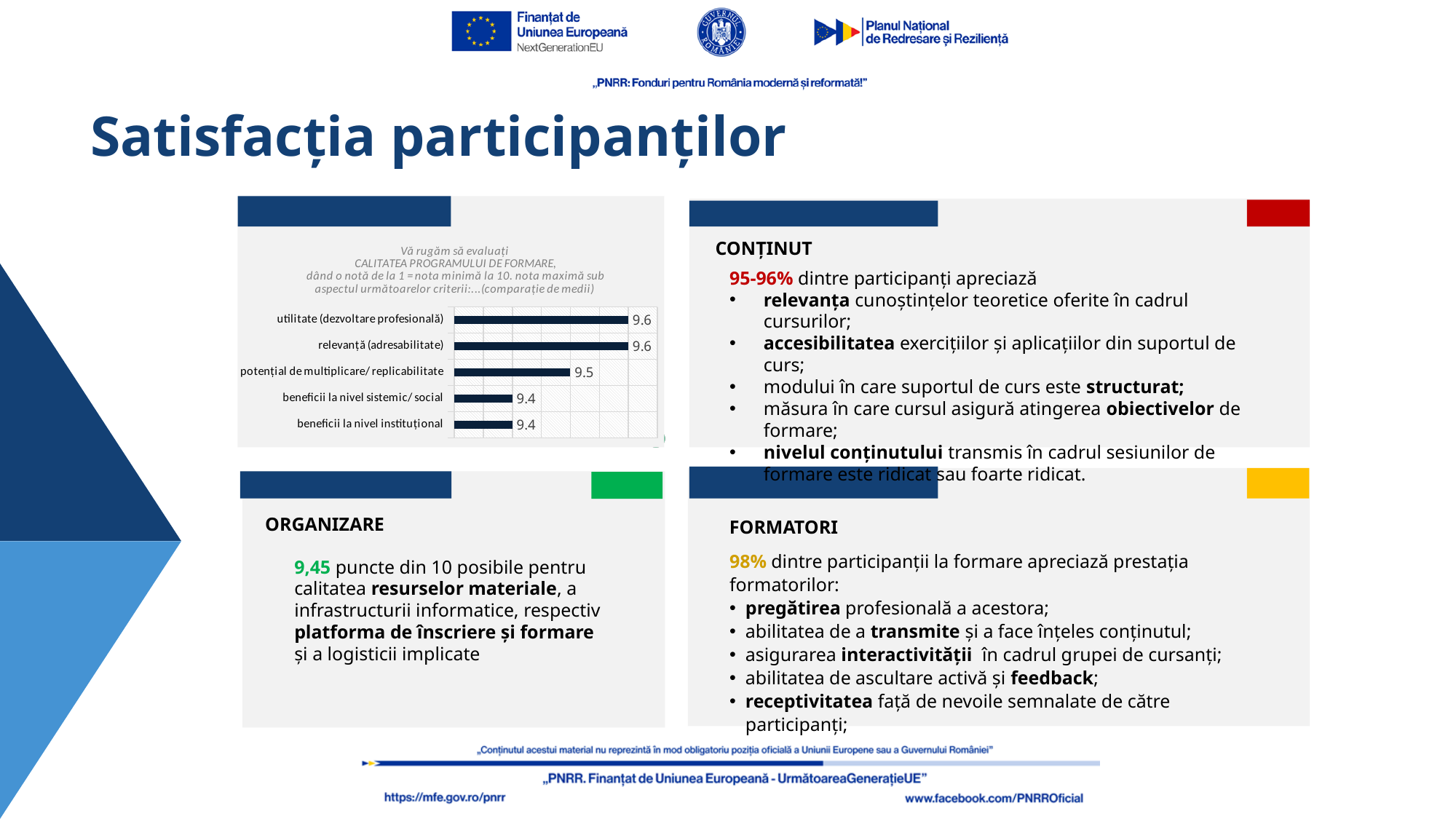
What is the value for 'beneficii la nivel sistemic/ social'? 9.4 What is the value for 'potențial de multiplicare/ replicabilitate'? 9.5 What is the difference between the value for 'utilitate (dezvoltare profesională)' and the value for 'beneficii la nivel instituțional'? 0.2 What kind of chart is shown on the slide? bar chart What is the value for 'relevanță (adresabilitate)'? 9.6 What is the value for 'beneficii la nivel instituțional'? 9.4 What is the highest value shown in the bar chart? 9.6 What is the difference between the value for 'relevanță (adresabilitate)' and the value for 'potențial de multiplicare/ replicabilitate'? 0.1 What is the lowest value shown in the bar chart? 9.4 Which is larger: the value for 'potențial de multiplicare/ replicabilitate' or the value for 'beneficii la nivel sistemic/ social'? potențial de multiplicare/ replicabilitate How many categories does the bar chart show? 5 What is the value for 'utilitate (dezvoltare profesională)'? 9.6